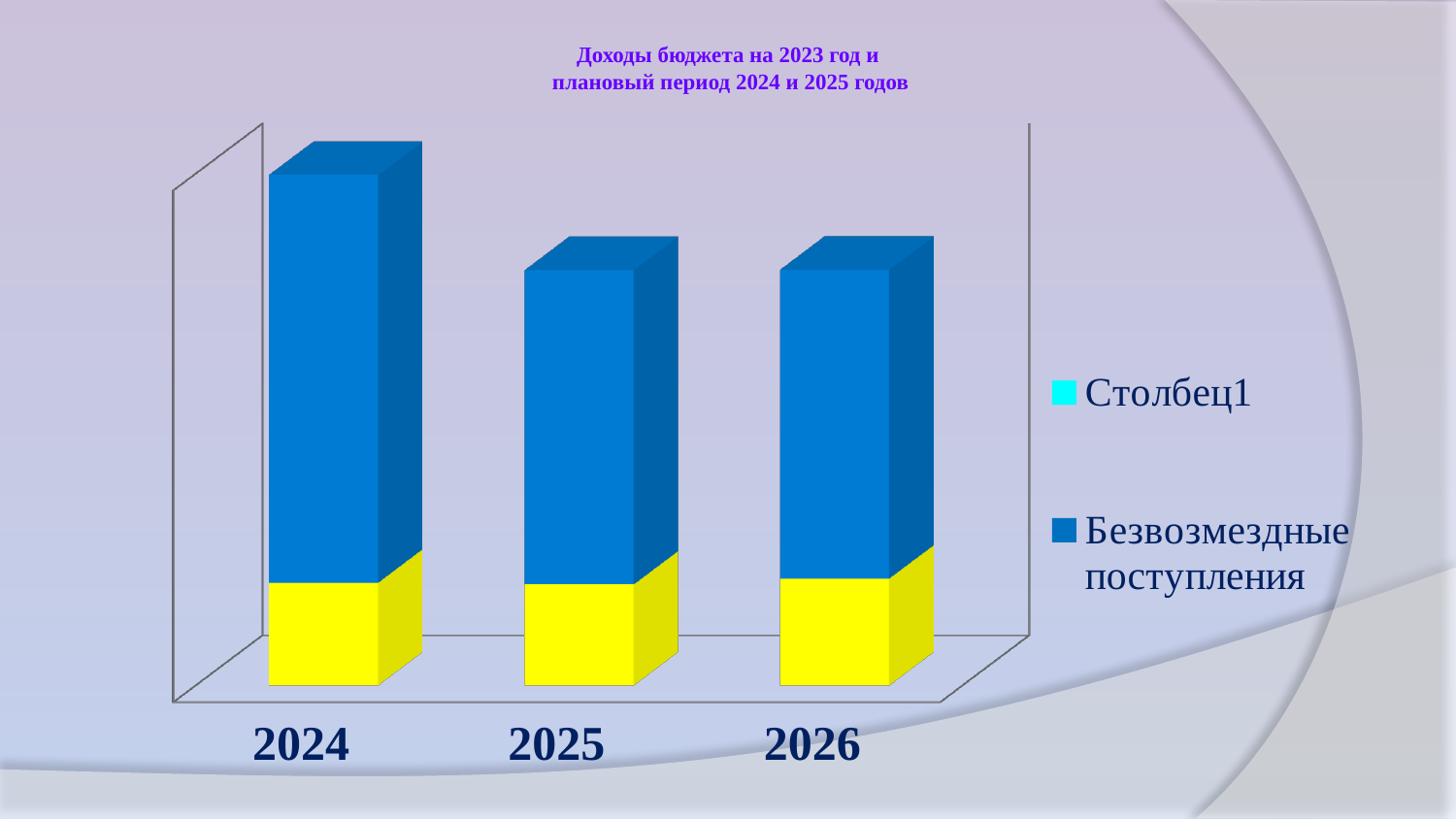
How many series does the chart legend list? 2 What is the last year shown on the x axis of the chart? 2026 Which bar is taller, 2024 or 2026? 2024 What kind of chart is shown on the slide? Stacked bar chart How many years (categories) are shown on the x axis of the chart? 3 What is the first year shown on the x axis of the chart? 2024 What is the title of the chart? Доходы бюджета на 2023 год и плановый период 2024 и 2025 годов Does the total bar height rise or fall from 2024 to 2025? Fall What are the two series names listed in the chart legend? Столбец1 and Безвозмездные поступления Which year has the tallest bar in the chart? 2024 Which bar is taller, 2024 or 2025? 2024